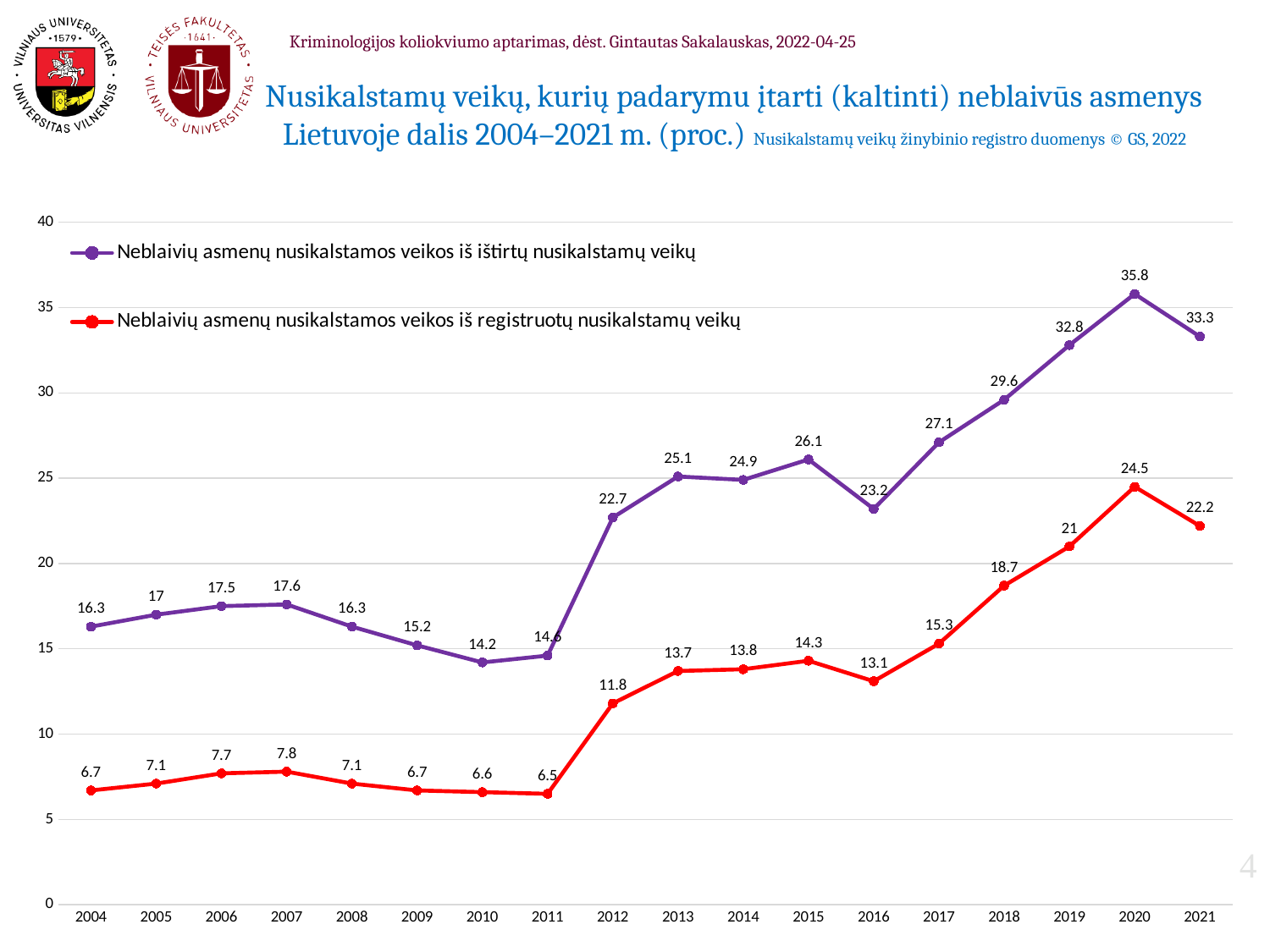
Does the red series (iš registruotų nusikalstamų veikų) rise or fall from 2016 to 2020? rise How many series does the legend list? 2 What is the value of the purple series (iš ištirtų nusikalstamų veikų) in 2020? 35.8 In which year does the purple series (iš ištirtų nusikalstamų veikų) have its lowest value? 2010 How many years are plotted along the x axis? 18 What colour is the line for 'Neblaivių asmenų nusikalstamos veikos iš registruotų nusikalstamų veikų'? red Which series has the larger value in 2016, the purple one or the red one? the purple one (iš ištirtų nusikalstamų veikų) What is the value of the red series (iš registruotų nusikalstamų veikų) in 2012? 11.8 In which year does the red series (iš registruotų nusikalstamų veikų) reach its highest value? 2020 What is the difference between the purple and red series values in 2021? 11.1 What type of chart is shown on the slide? line chart Is the value of the red series in 2019 greater or less than 20? greater